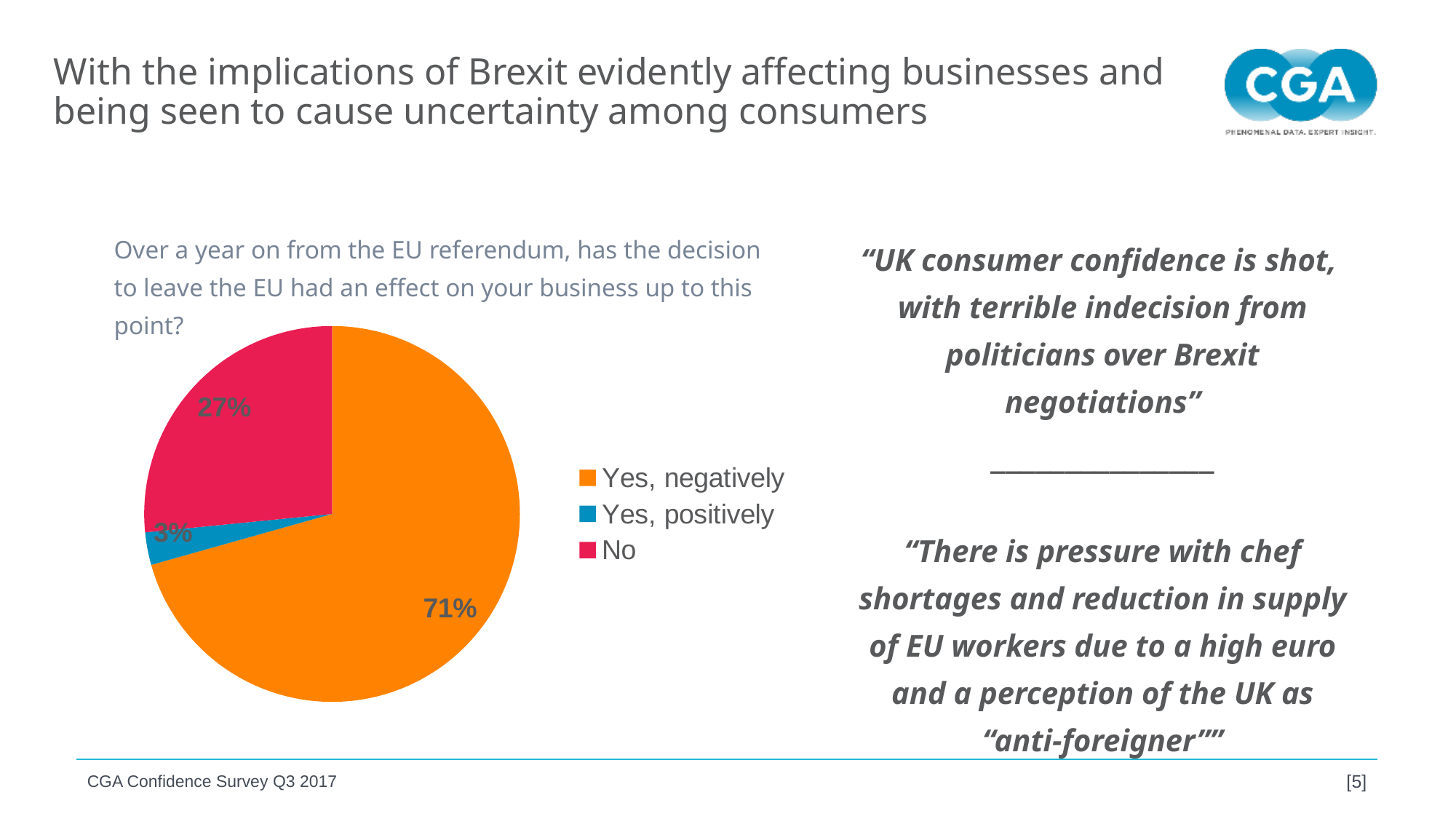
What share of respondents answered "No"? 27% What is the combined share of respondents who said the decision had an effect (positively or negatively)? 74% What share of respondents answered "Yes, negatively"? 71% Which is larger: the share for "No" or the share for "Yes, positively"? No What colour is the "No" slice of the pie? pink/red How many categories does the pie chart have? 3 What kind of chart is shown on the slide? pie chart What share of respondents answered "Yes, positively"? 3% What is the difference in percentage points between "Yes, negatively" and "No"? 44 Which response has the largest slice of the pie? Yes, negatively Which response has the smallest slice of the pie? Yes, positively How many entries does the legend list? 3